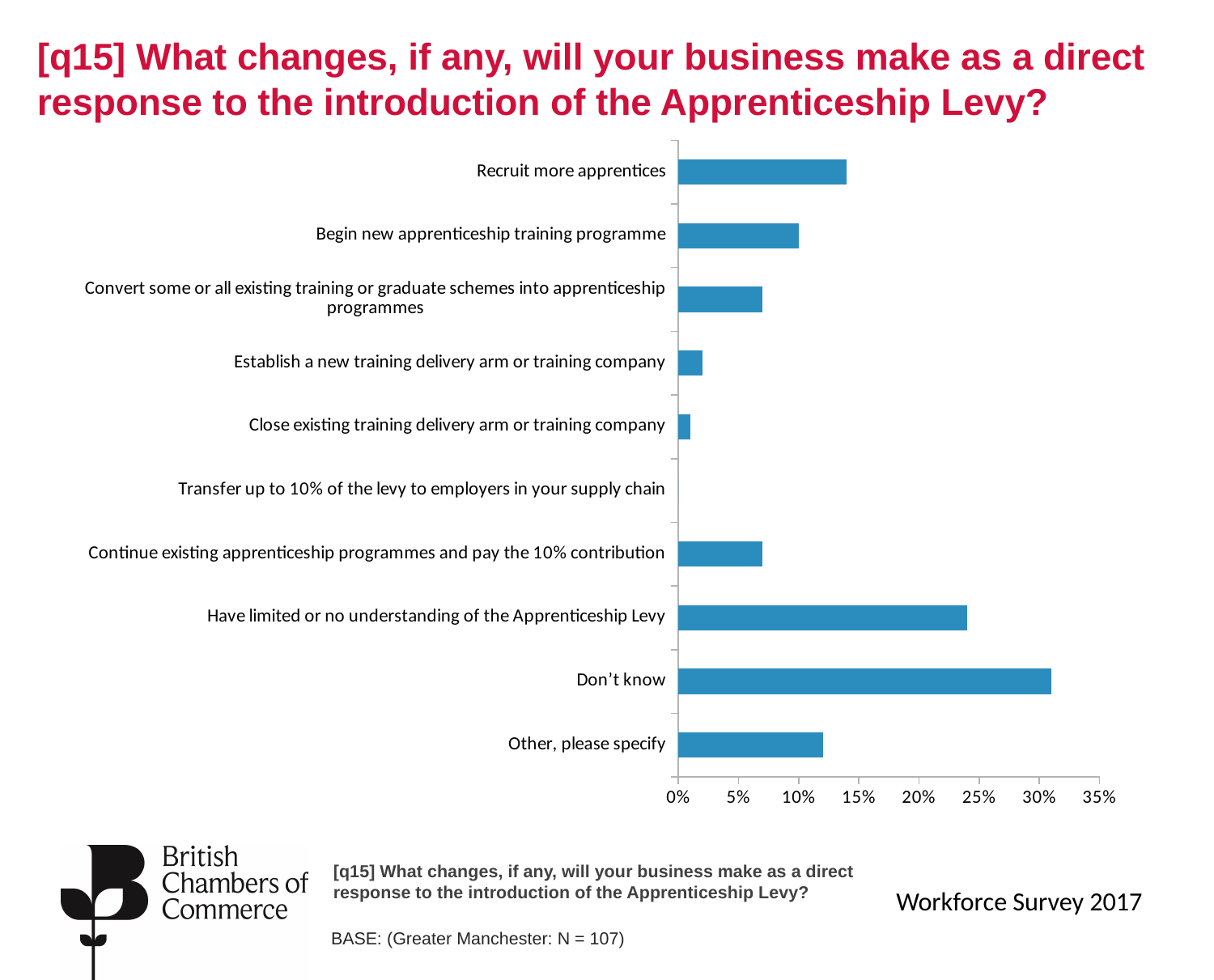
How many response categories are plotted on the chart? 10 Is the value for "Establish a new training delivery arm or training company" greater or less than 5%? less What is the maximum value shown on the horizontal axis of the chart? 35% Which response category has the lowest value? Transfer up to 10% of the levy to employers in your supply chain Which response category has the highest value? Don't know Which is larger: the value for "Recruit more apprentices" or the value for "Establish a new training delivery arm or training company"? Recruit more apprentices Is the value for "Have limited or no understanding of the Apprenticeship Levy" greater or less than 20%? greater Which is larger: the value for "Don't know" or the value for "Have limited or no understanding of the Apprenticeship Levy"? Don't know Is the value for "Recruit more apprentices" greater or less than 10%? greater What kind of chart is shown on the slide? bar chart What is the value for "Transfer up to 10% of the levy to employers in your supply chain"? 0%